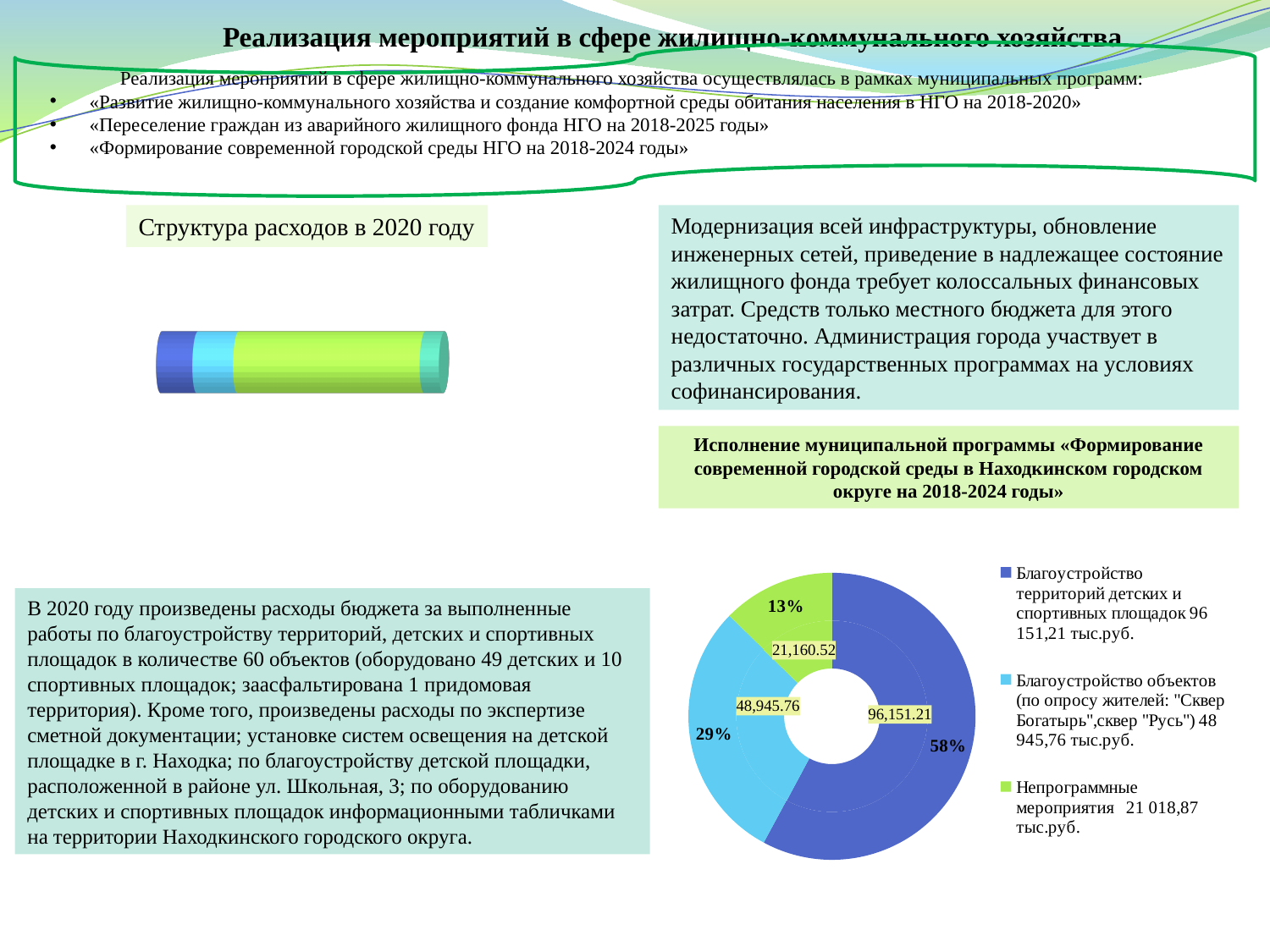
In the pie chart at the bottom right of the slide, what is the difference between the values for «Благоустройство территорий детских и спортивных площадок» and «Благоустройство объектов (по опросу жителей)»? 47,205.45 In the pie chart at the bottom right of the slide, what percentage share does «Благоустройство территорий детских и спортивных площадок» have? 58% In the pie chart at the bottom right of the slide, how many slices (categories) are there? 3 In the pie chart at the bottom right of the slide, what value is shown for «Благоустройство объектов (по опросу жителей)»? 48,945.76 In the pie chart at the bottom right of the slide, what value is shown for «Благоустройство территорий детских и спортивных площадок»? 96,151.21 What kind of chart is shown at the bottom right of the slide? Pie (doughnut) chart In the pie chart at the bottom right of the slide, which category has the largest slice? Благоустройство территорий детских и спортивных площадок In the pie chart at the bottom right of the slide, what percentage share does «Благоустройство объектов (по опросу жителей)» have? 29% In the pie chart at the bottom right of the slide, what value is shown for «Непрограммные мероприятия»? 21,160.52 In the pie chart at the bottom right of the slide, which category has the smallest slice? Непрограммные мероприятия How many entries does the legend of the pie chart at the bottom right of the slide list? 3 In the pie chart at the bottom right of the slide, what percentage share does «Непрограммные мероприятия» have? 13%